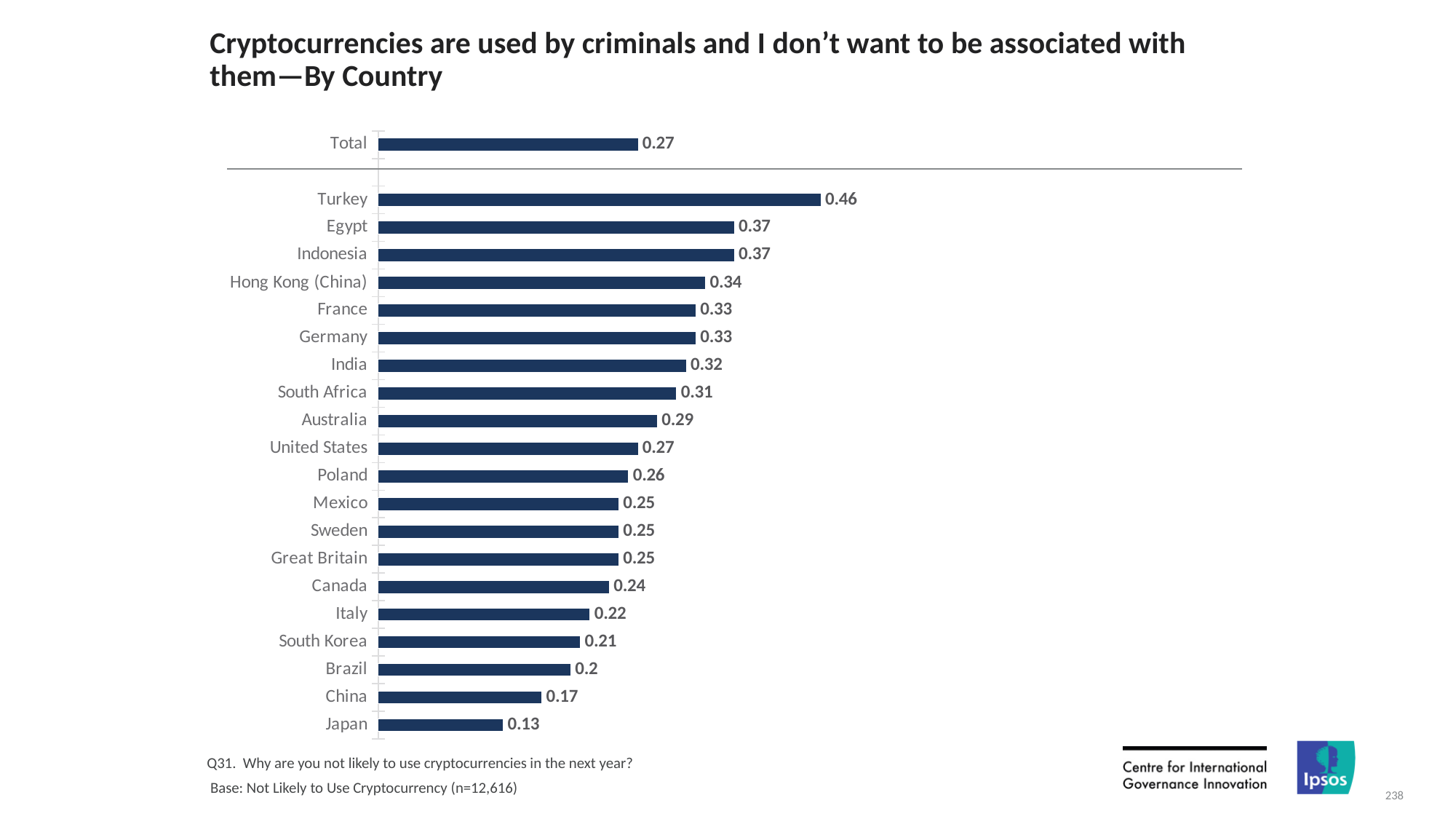
Which has a larger value, India or Brazil? India Which country has the highest value? Turkey Which country has the lowest value? Japan What is the difference between the values for Egypt and Canada? 0.13 How many countries are shown in the chart, excluding the Total bar? 20 What is the value for Hong Kong (China)? 0.34 What is the difference between the values for Turkey and Japan? 0.33 What is the value for Japan? 0.13 What kind of chart is shown on the slide? Bar chart What is the value for the Total bar? 0.27 What is the title of the chart? Cryptocurrencies are used by criminals and I don't want to be associated with them—By Country What is the value for Turkey? 0.46